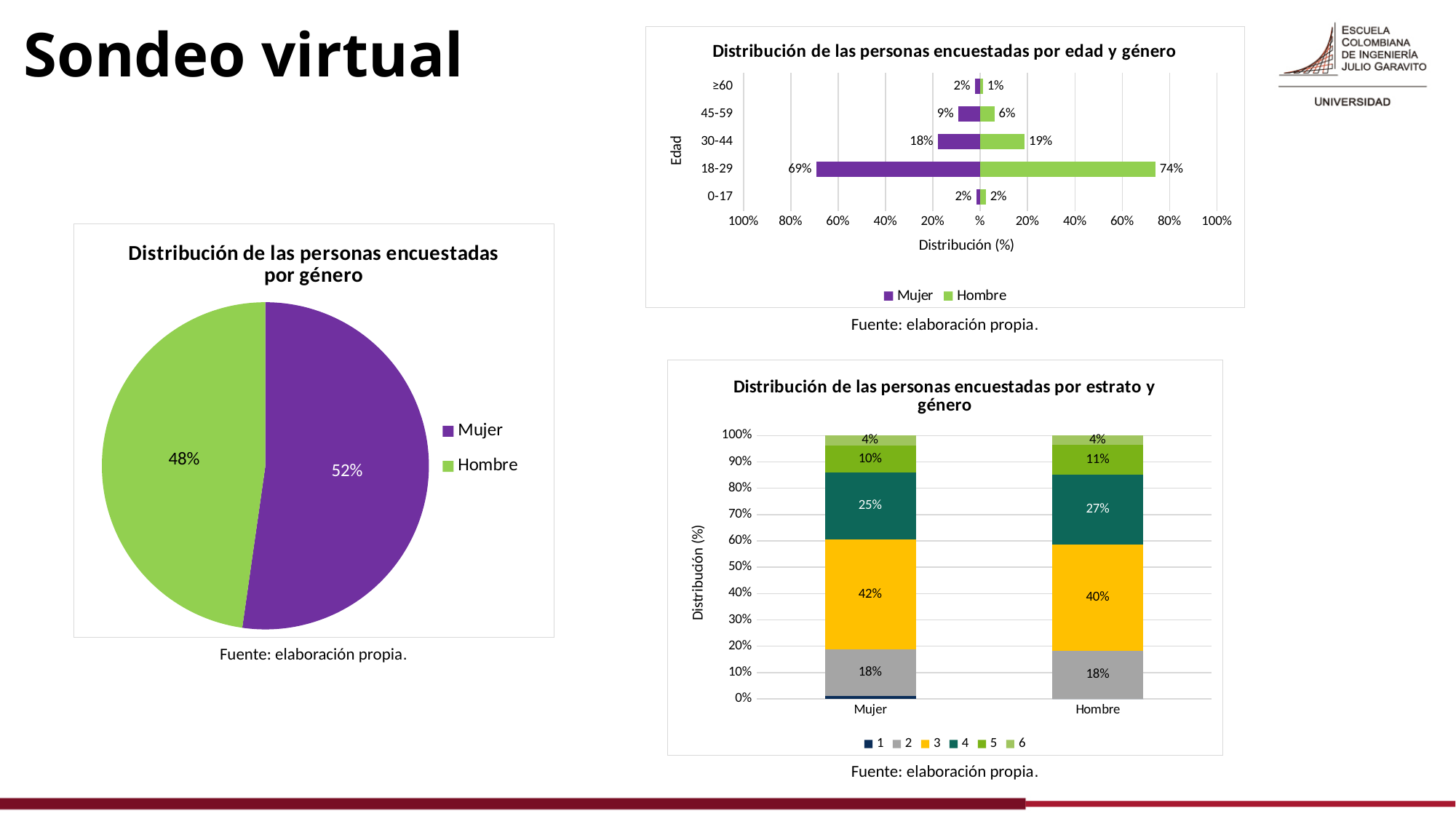
In the chart 'Distribución de las personas encuestadas por edad y género', what is the difference between the Hombre and Mujer values for the 45-59 age group? 3% In the chart 'Distribución de las personas encuestadas por edad y género', how many age groups are shown on the y axis? 5 In the chart 'Distribución de las personas encuestadas por estrato y género', how many series does the legend list? 6 In the chart 'Distribución de las personas encuestadas por estrato y género', what is the value for series 3 in the Hombre bar? 40% In the chart 'Distribución de las personas encuestadas por género', what share of the pie is Mujer? 52% What kind of chart is 'Distribución de las personas encuestadas por género'? Pie chart In the chart 'Distribución de las personas encuestadas por estrato y género', which is larger: series 4 for Mujer or series 4 for Hombre? Hombre What kind of chart is 'Distribución de las personas encuestadas por edad y género'? Bar chart In the chart 'Distribución de las personas encuestadas por género', what share of the pie is Hombre? 48% In the chart 'Distribución de las personas encuestadas por edad y género', what is the value for Hombre in the 30-44 age group? 19% In the chart 'Distribución de las personas encuestadas por edad y género', what is the value for Mujer in the 18-29 age group? 69% In the chart 'Distribución de las personas encuestadas por edad y género', which age group has the highest value for Hombre? 18-29